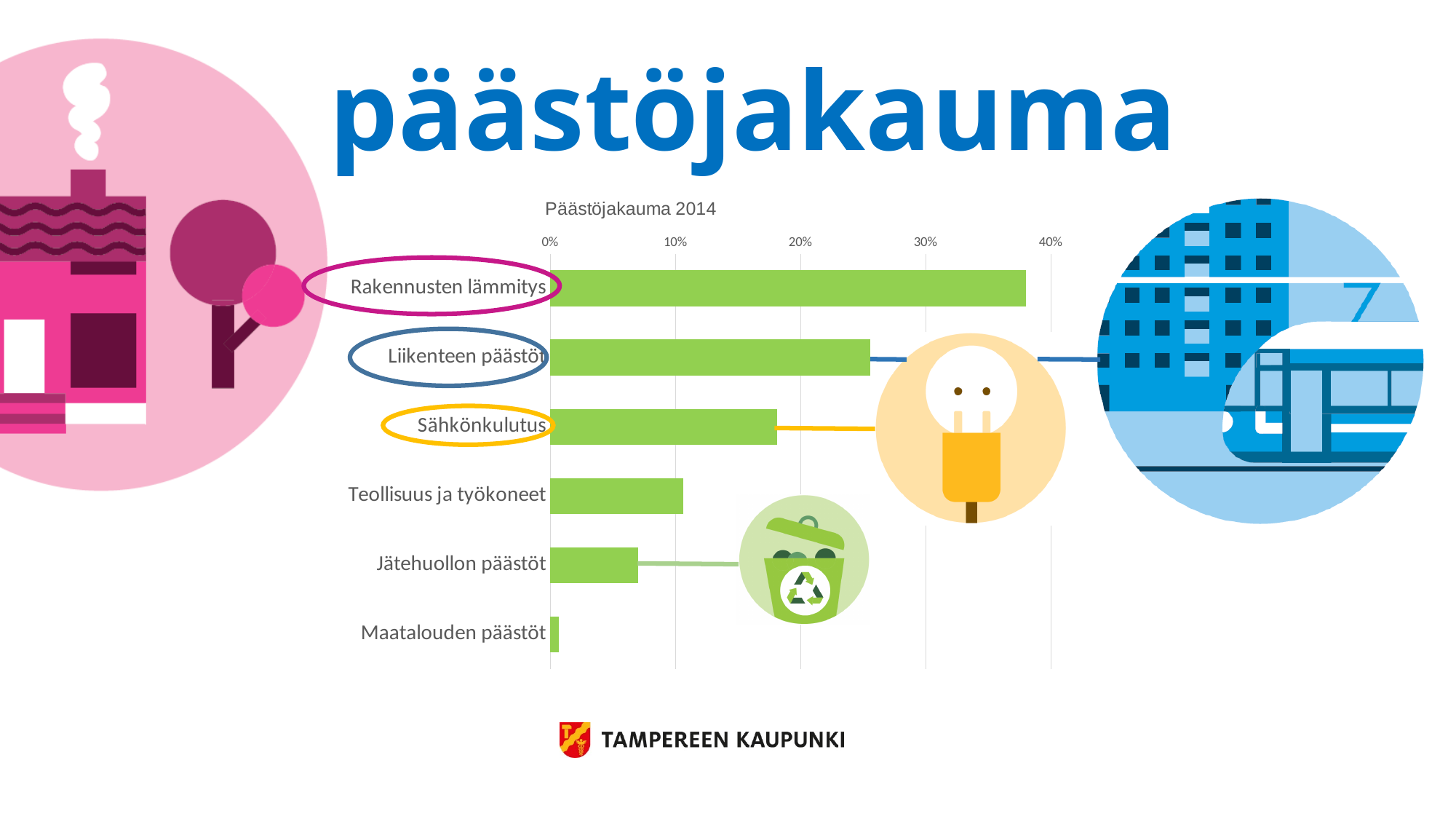
What is the title of the chart? Päästöjakauma 2014 Is the value for Rakennusten lämmitys greater or less than 30%? greater Is the value for Sähkönkulutus greater or less than 20%? less Which is larger, the value for Teollisuus ja työkoneet or the value for Jätehuollon päästöt? Teollisuus ja työkoneet What is the highest value shown on the percentage axis of the chart? 40% How many categories are plotted in the chart? 6 Which is larger, the value for Liikenteen päästöt or the value for Sähkönkulutus? Liikenteen päästöt Which category has the highest value in the chart? Rakennusten lämmitys Is the value for Jätehuollon päästöt greater or less than 10%? less What kind of chart is shown on the slide? bar chart Which category has the lowest value in the chart? Maatalouden päästöt